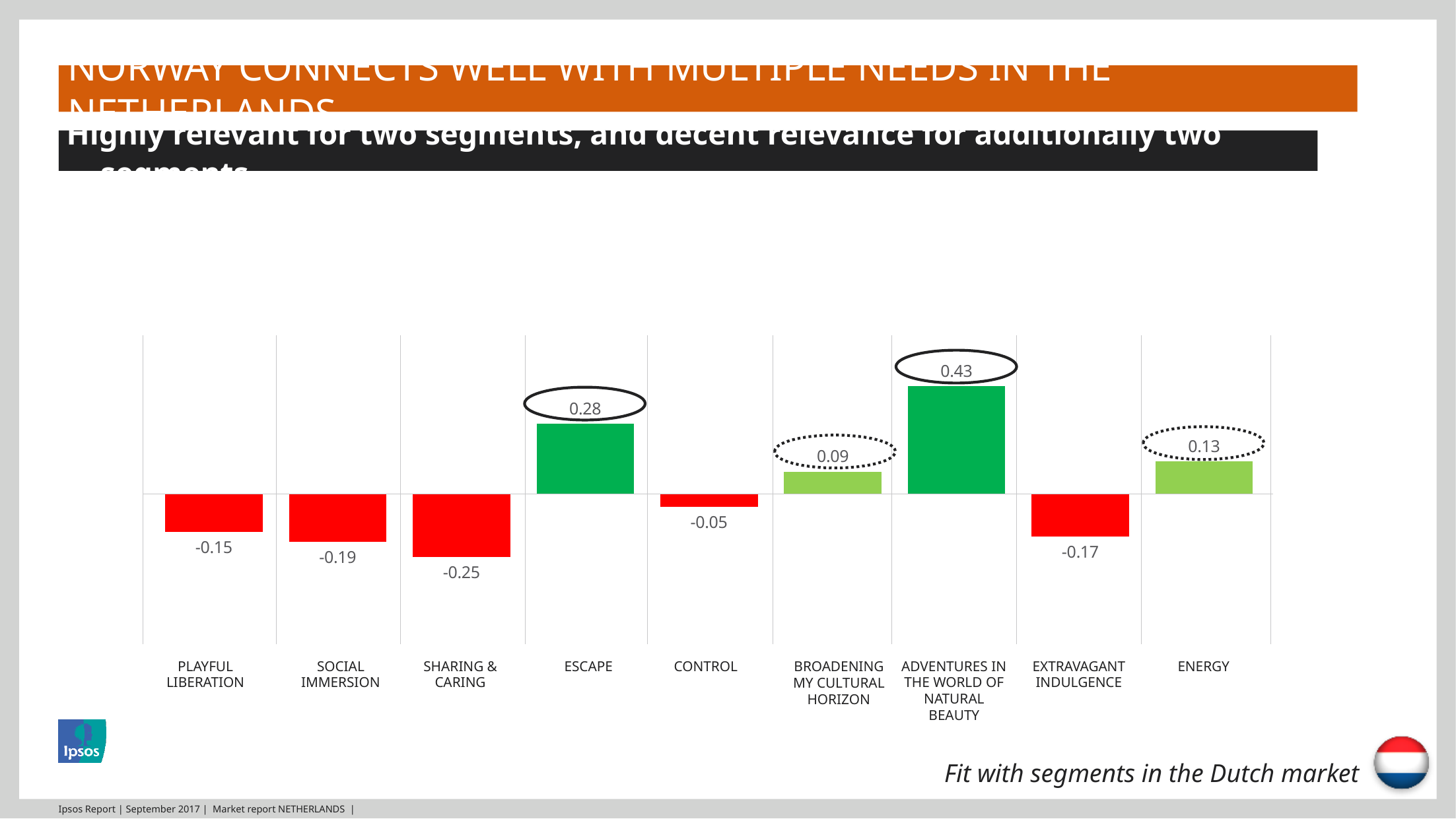
What is the value for ESCAPE? 0.28 What is the value for ADVENTURES IN THE WORLD OF NATURAL BEAUTY? 0.43 Which category has the highest value? ADVENTURES IN THE WORLD OF NATURAL BEAUTY Which category has the lowest value? SHARING & CARING What kind of chart is shown on the slide? Bar chart What is the value for SHARING & CARING? -0.25 How many categories are shown on the x axis? 9 What is the value for CONTROL? -0.05 What is the difference between the values for ADVENTURES IN THE WORLD OF NATURAL BEAUTY and ESCAPE? 0.15 How many categories have a negative value? 5 Which is larger, the value for ENERGY or the value for BROADENING MY CULTURAL HORIZON? ENERGY What colour are the bars with negative values? Red